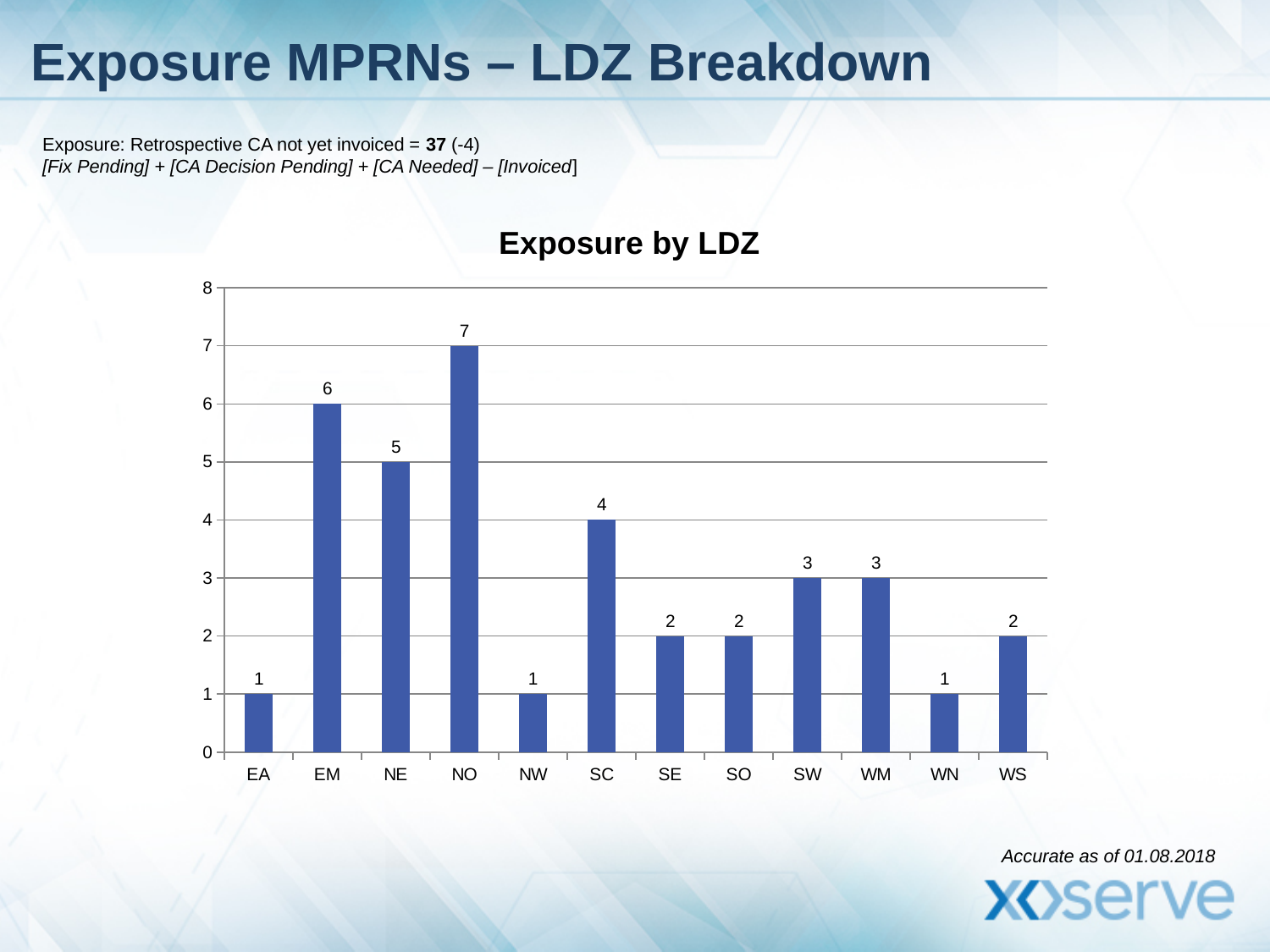
Which is larger, the value for SW or the value for SE? SW What is the title of the chart on the slide? Exposure by LDZ What is the maximum value shown on the y axis of the chart? 8 How many LDZ categories are shown on the x axis of the chart? 12 What is the value for NO in the Exposure by LDZ chart? 7 What is the value for WS in the Exposure by LDZ chart? 2 What is the difference between the values for EM and NE? 1 Which LDZ has the highest exposure value? NO What is the value for SC in the Exposure by LDZ chart? 4 What kind of chart is used to show Exposure by LDZ? Bar chart What is the difference between the values for NO and SC? 3 Which is larger, the value for EM or the value for WM? EM